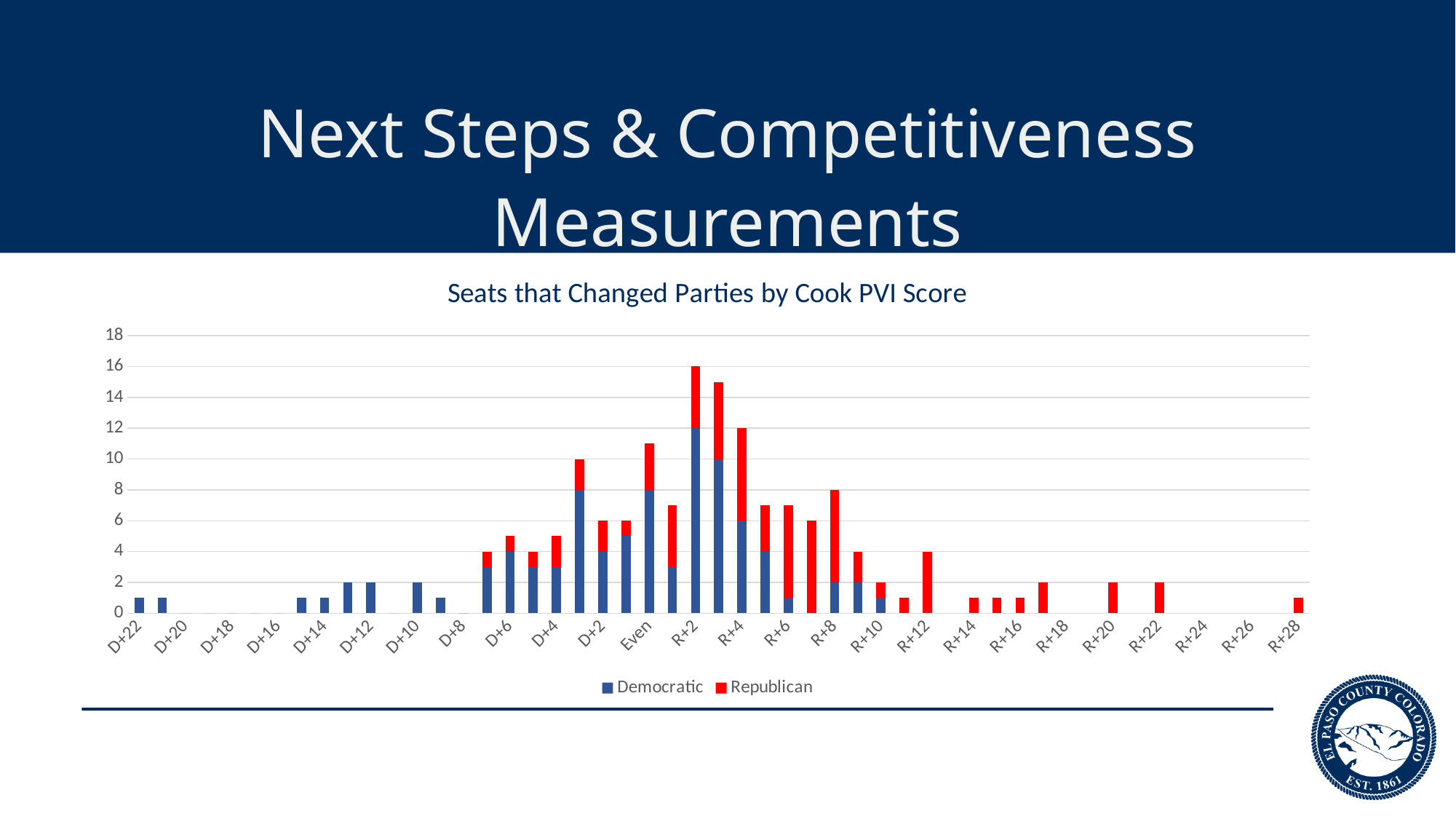
How many series does the legend list? 2 What is the Democratic value for R+2? 12 What is the Democratic value for the Even category? 8 Which colour represents the Republican series in the legend? red What is the total height of the stacked bar for R+2? 16 What kind of chart is shown on the slide? stacked bar chart What is the total height of the stacked bar for R+8? 8 What is the total height of the stacked bar for R+4? 12 Which has a taller total bar, R+2 or R+4? R+2 Which Cook PVI category has the tallest bar? R+2 Is the total for the Even category greater or less than 10? greater What is the difference between the total bar heights for R+2 and R+4? 4